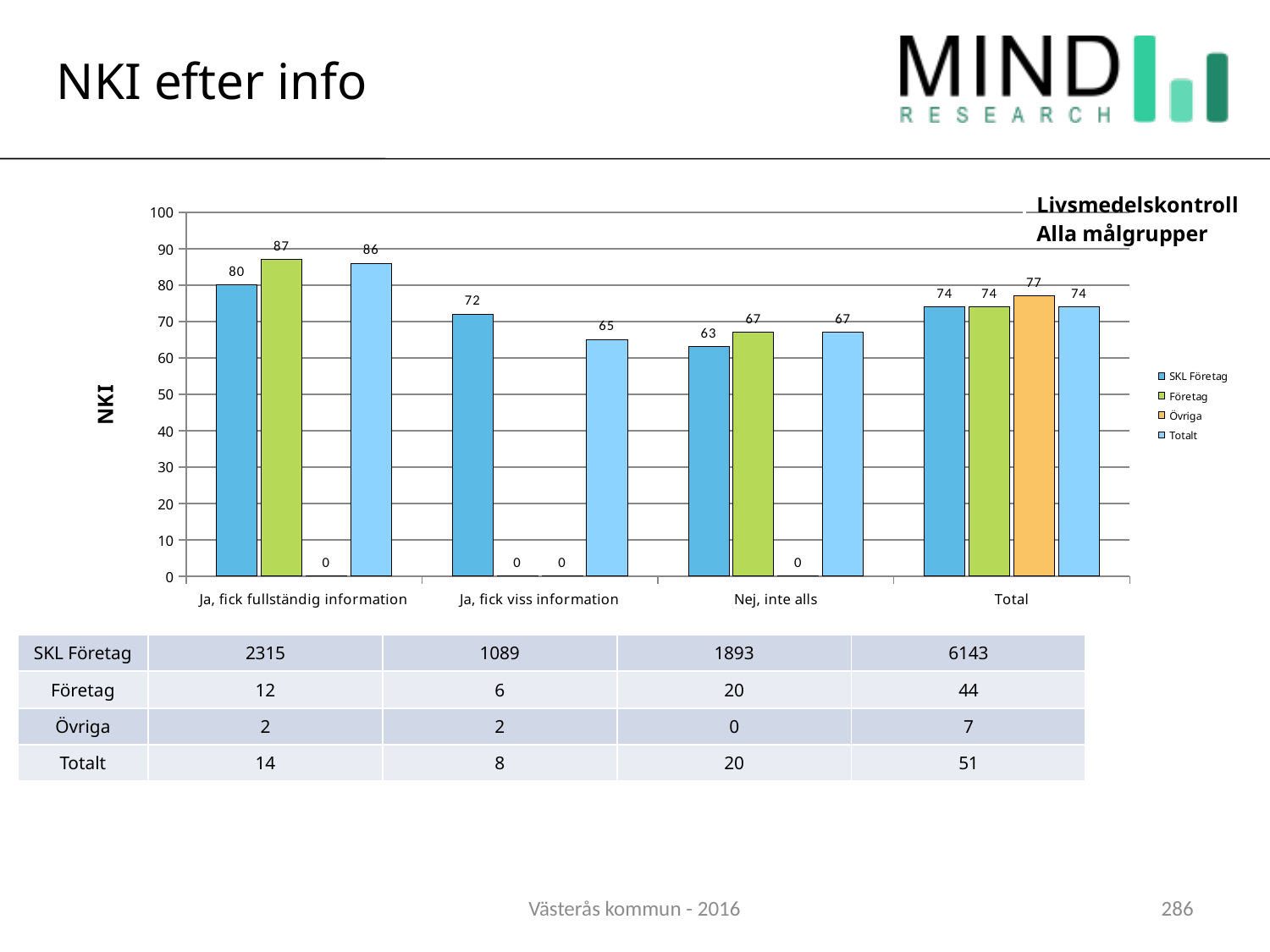
How many series does the chart legend list? 4 What is the label of the y axis of the chart? NKI Which category has the lowest NKI value for SKL Företag? Nej, inte alls How many categories are shown on the x axis of the chart? 4 Which is larger: the SKL Företag value for 'Ja, fick viss information' or the SKL Företag value for 'Nej, inte alls'? Ja, fick viss information What is the NKI value for Övriga in the 'Total' category? 77 What is the NKI value for Företag in the category 'Ja, fick fullständig information'? 87 Which category has the highest NKI value for SKL Företag? Ja, fick fullständig information What is the NKI value for SKL Företag in the category 'Ja, fick fullständig information'? 80 What is the difference between the Företag value and the SKL Företag value in the category 'Ja, fick fullständig information'? 7 What is the NKI value for Totalt in the category 'Ja, fick viss information'? 65 What kind of chart is shown on the slide? Bar chart